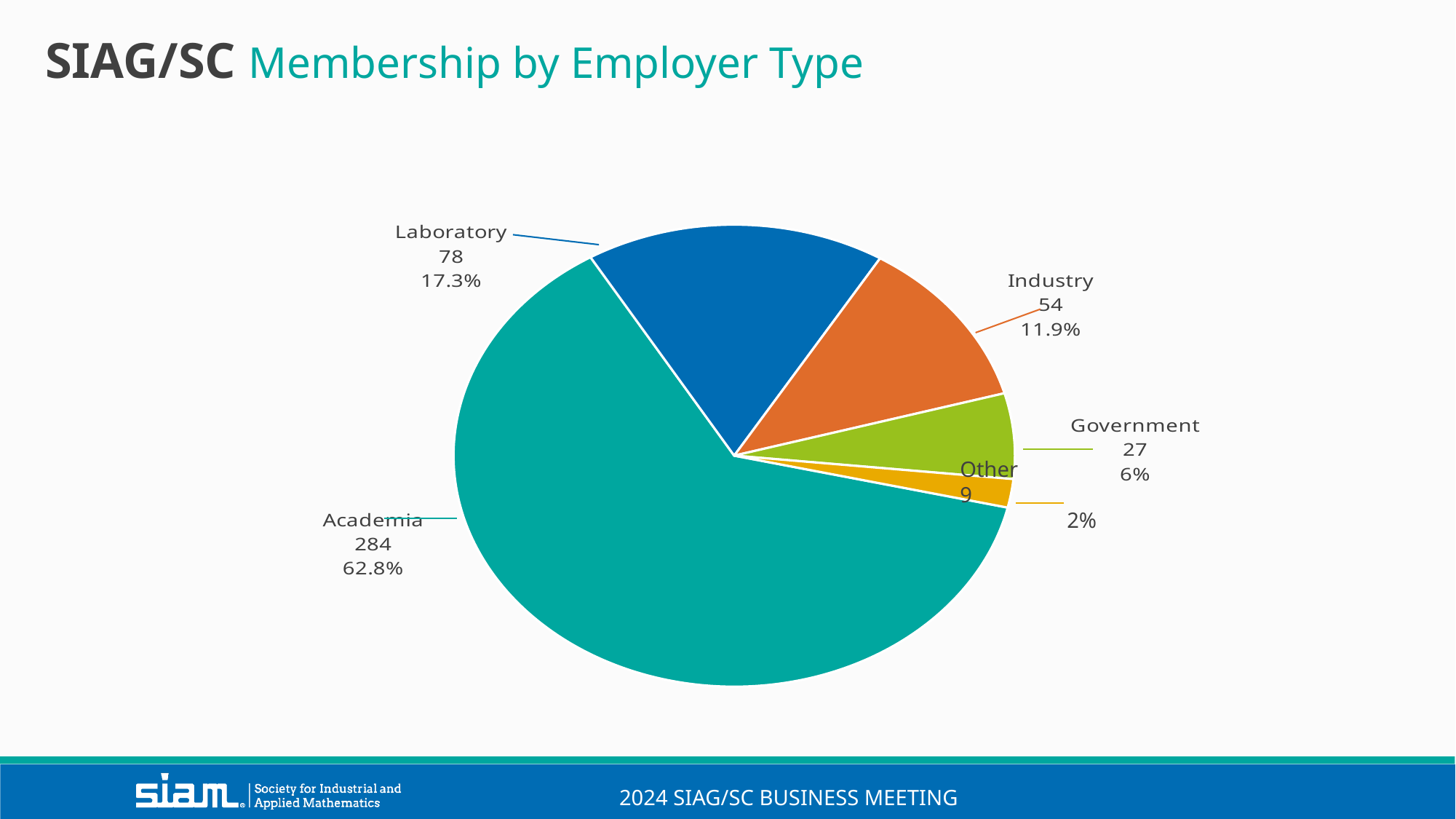
Which employer type has the smallest slice? Other How many employer type categories are shown in the pie chart? 5 How many members are in the Academia category? 284 Which has more members, Industry or Government? Industry What is the title of the slide? SIAG/SC Membership by Employer Type What is the difference in member count between Laboratory and Industry? 24 Which employer type has the largest slice? Academia How many members are in the Industry category? 54 How many members are in the Other category? 9 What share of the pie does Government represent? 6% What percentage of membership is Laboratory? 17.3% What type of chart is shown on the slide? pie chart